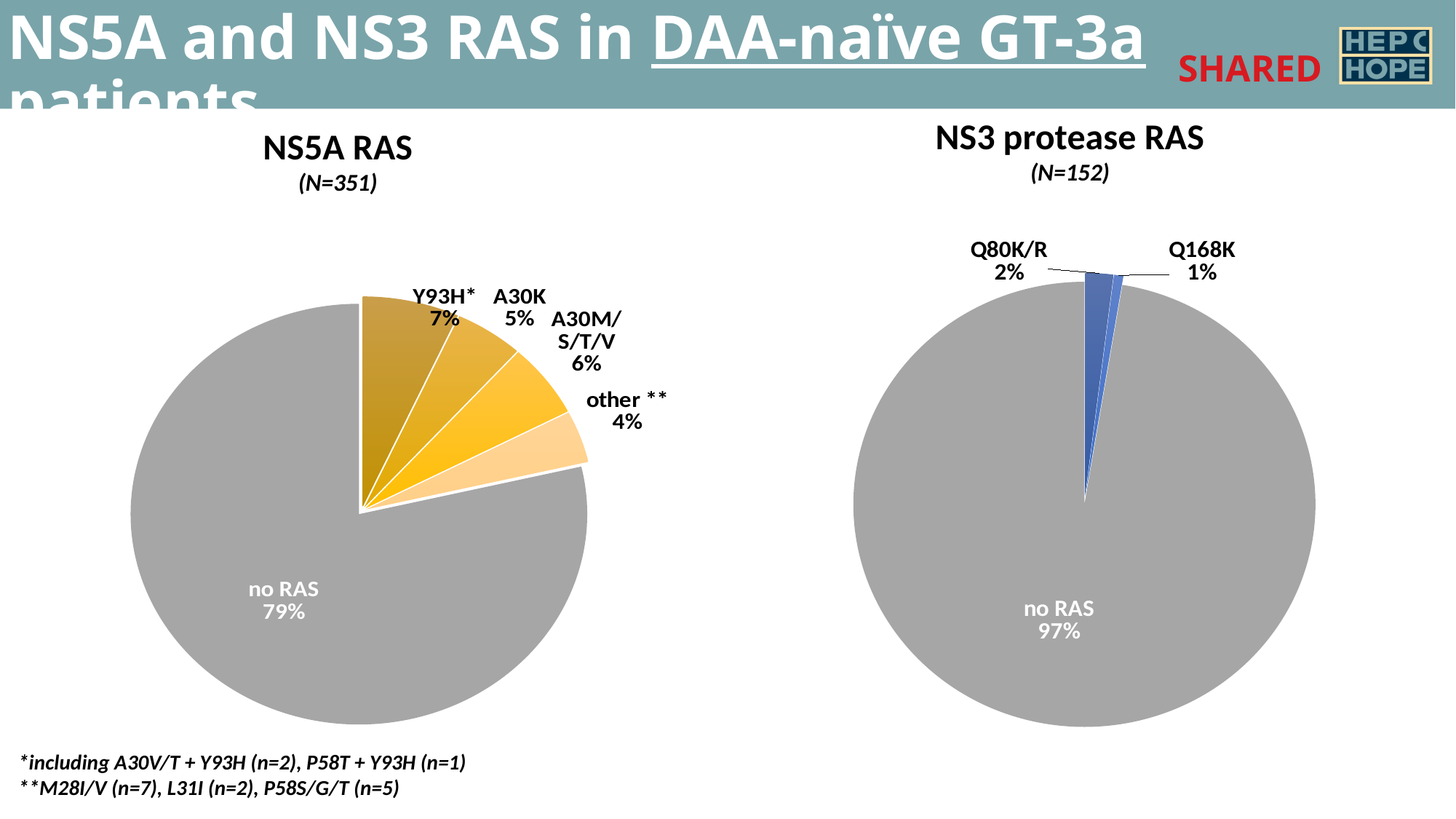
In the NS5A RAS pie chart, which RAS slice (excluding no RAS) is the largest? Y93H* In the NS3 protease RAS pie chart, what is the share for Q80K/R? 2% In the NS5A RAS pie chart, what is the share for A30M/S/T/V? 6% How many slices does the NS5A RAS pie chart have? 5 In the NS5A RAS pie chart, what is the share for Y93H*? 7% In the NS3 protease RAS pie chart, what percentage of patients have no RAS? 97% In the NS3 protease RAS pie chart, which slice is the smallest? Q168K In the NS5A RAS pie chart, what is the difference between the Y93H* share and the other** share? 3% In the NS5A RAS pie chart, what percentage of patients have no RAS? 79% What type of chart is used for NS3 protease RAS? Pie chart